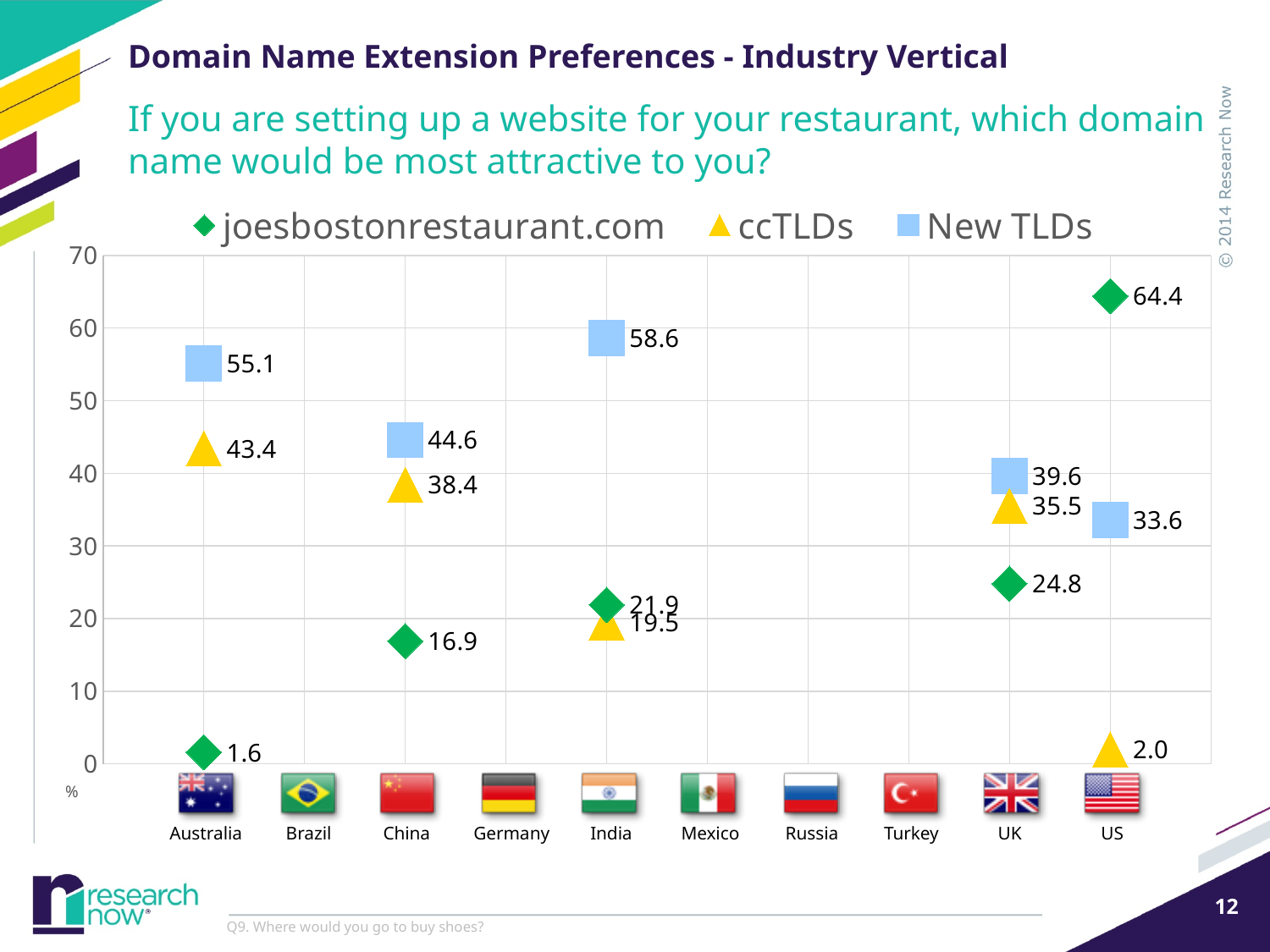
What is the value for ccTLDs in Australia? 43.4 What is the value for New TLDs in India? 58.6 What is the value for joesbostonrestaurant.com in the US? 64.4 Which country has the lowest value for ccTLDs? US How many countries are shown on the x axis? 10 Which country has the highest value for joesbostonrestaurant.com? US Which is larger in India: the value for joesbostonrestaurant.com or the value for ccTLDs? joesbostonrestaurant.com Is the value for New TLDs in the US greater or less than 40? less What is the difference between the New TLDs value and the ccTLDs value in China? 6.2 Which marker shape and colour represents ccTLDs in the legend? Yellow triangle How many series does the legend list? 3 What is the value for ccTLDs in the UK? 35.5